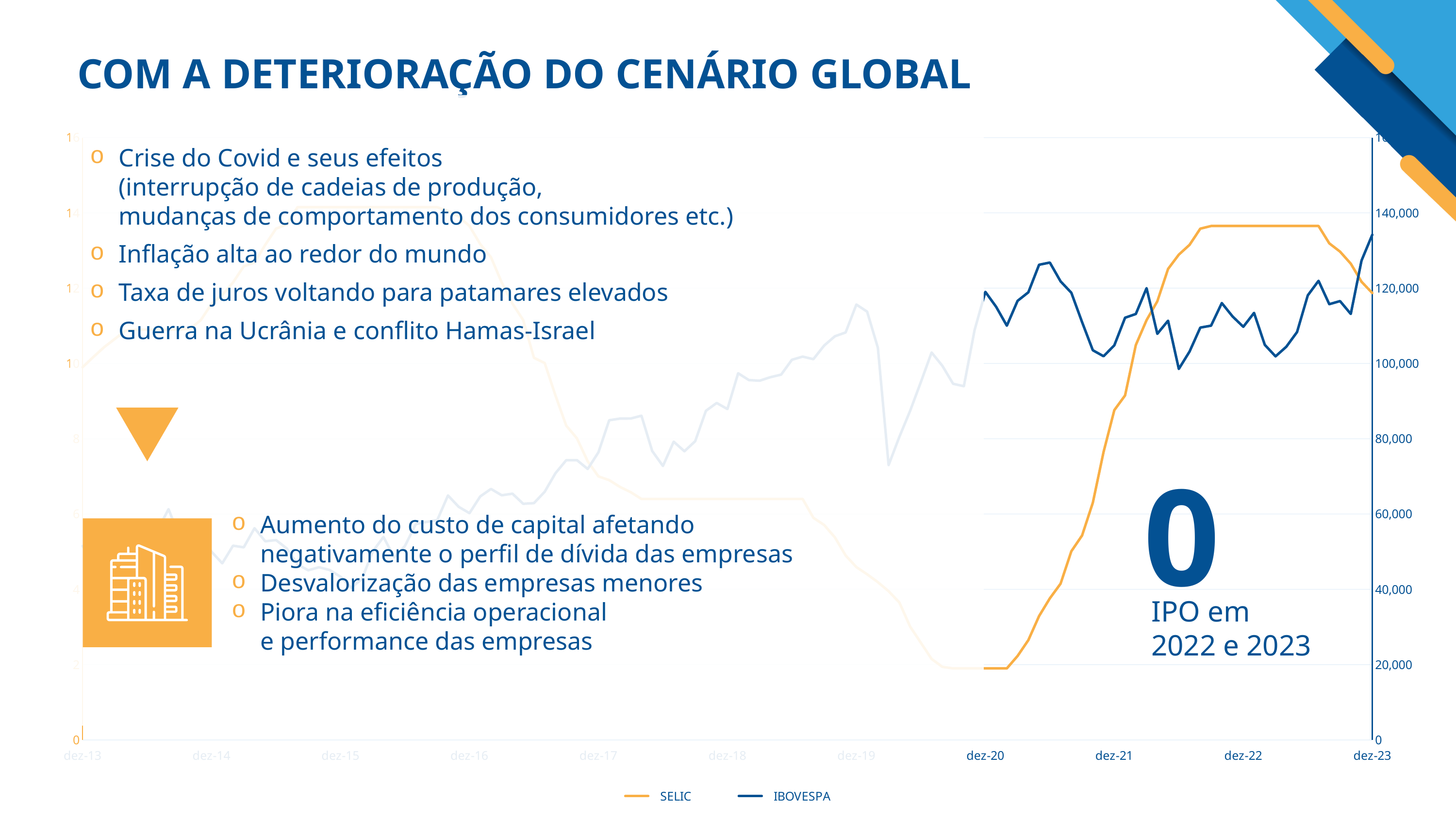
How many date labels are shown along the x axis of the chart? 11 Does the SELIC line rise or fall between dez-20 and dez-22? rise What colour is the SELIC line in the chart? orange Which series is higher on its own axis at dez-20 relative to the axis maximum: SELIC (left axis, max 16) or IBOVESPA (right axis, max 160,000)? IBOVESPA Does the SELIC line rise or fall between dez-22 and dez-23? fall Is the SELIC value at dez-22 greater or less than 12 on the left axis? greater Is the SELIC value at dez-20 greater or less than 4 on the left axis? less What kind of chart is shown on the slide? line chart Is the IBOVESPA value at dez-23 greater or less than 120,000 on the right axis? greater How many series does the chart legend list? 2 Which two series are listed in the chart legend? SELIC and IBOVESPA